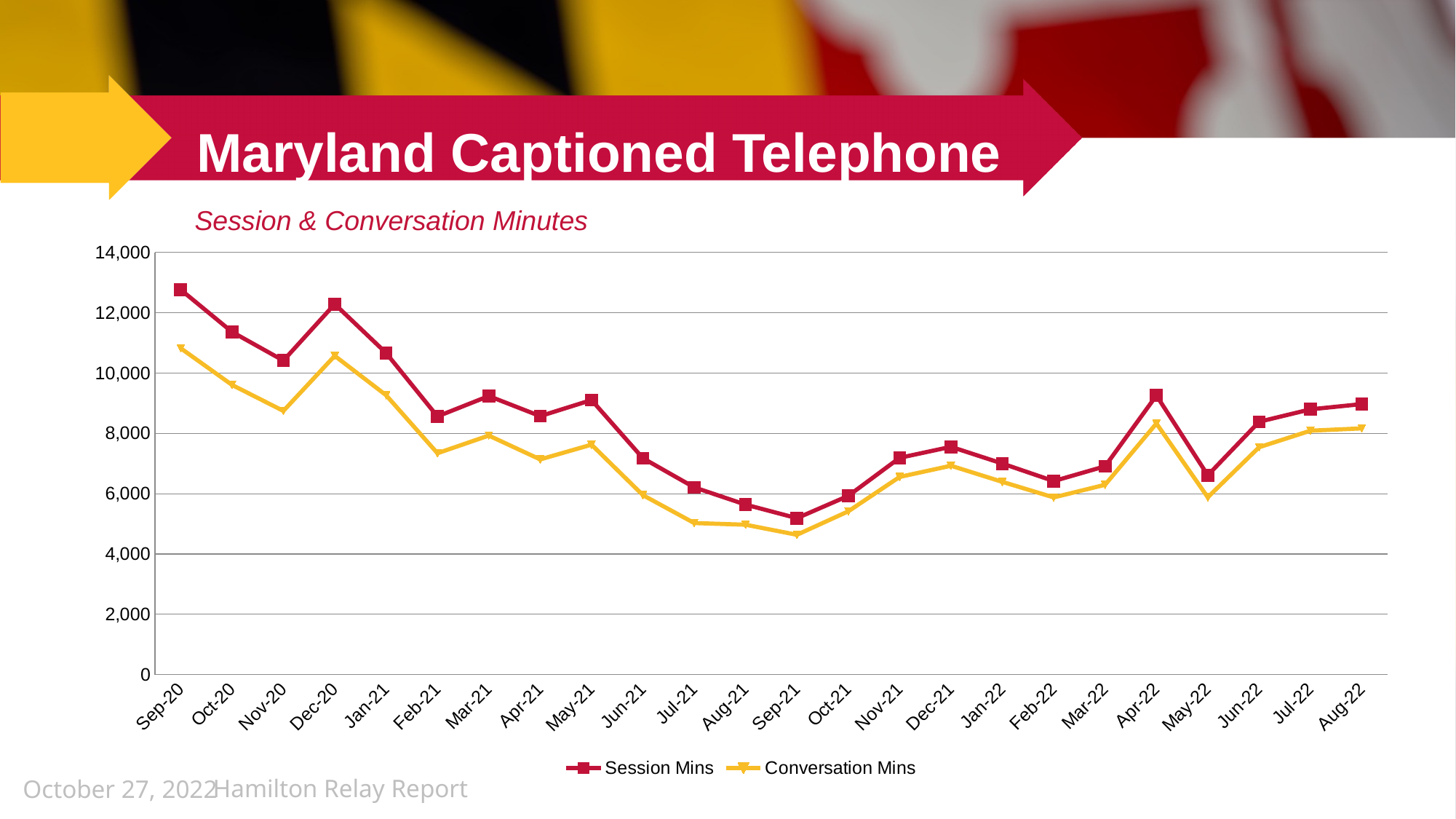
How many series does the legend list? 2 In which month is Session Mins lowest? Sep-21 What is the subtitle of the chart? Session & Conversation Minutes In which month is Conversation Mins lowest? Sep-21 What kind of chart is shown on the slide? Line chart Which is larger in Dec-20, Session Mins or Conversation Mins? Session Mins In which month is Session Mins highest? Sep-20 Do Session Mins rise or fall from Sep-20 to Sep-21? Fall How many months are plotted along the x axis? 24 Is the value for Conversation Mins in Sep-21 greater or less than 6,000? less Is the value for Session Mins in Sep-20 greater or less than 12,000? greater Is the value for Session Mins in Apr-22 greater or less than 8,000? greater